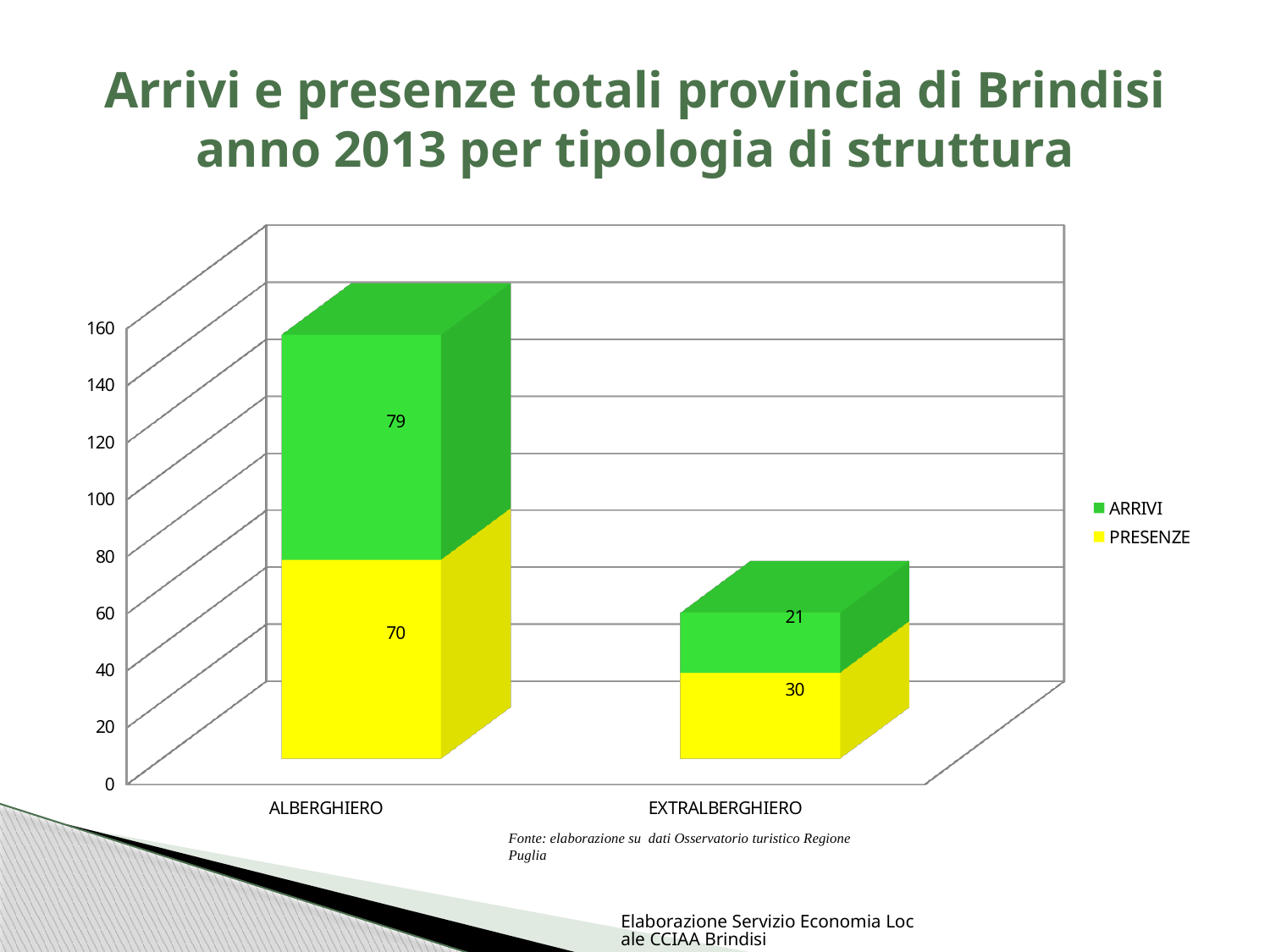
What is the difference between the PRESENZE values for ALBERGHIERO and EXTRALBERGHIERO? 40 What is the PRESENZE value for EXTRALBERGHIERO? 30 Which category has the lowest PRESENZE value? EXTRALBERGHIERO What is the PRESENZE value for ALBERGHIERO? 70 What is the ARRIVI value for ALBERGHIERO? 79 Which is larger: ARRIVI for ALBERGHIERO or ARRIVI for EXTRALBERGHIERO? ARRIVI for ALBERGHIERO What is the ARRIVI value for EXTRALBERGHIERO? 21 What is the total of the stacked bar for EXTRALBERGHIERO? 51 How many categories are shown on the x axis? 2 What is the total of the stacked bar for ALBERGHIERO? 149 Which category has the highest ARRIVI value? ALBERGHIERO How many series does the legend list? 2